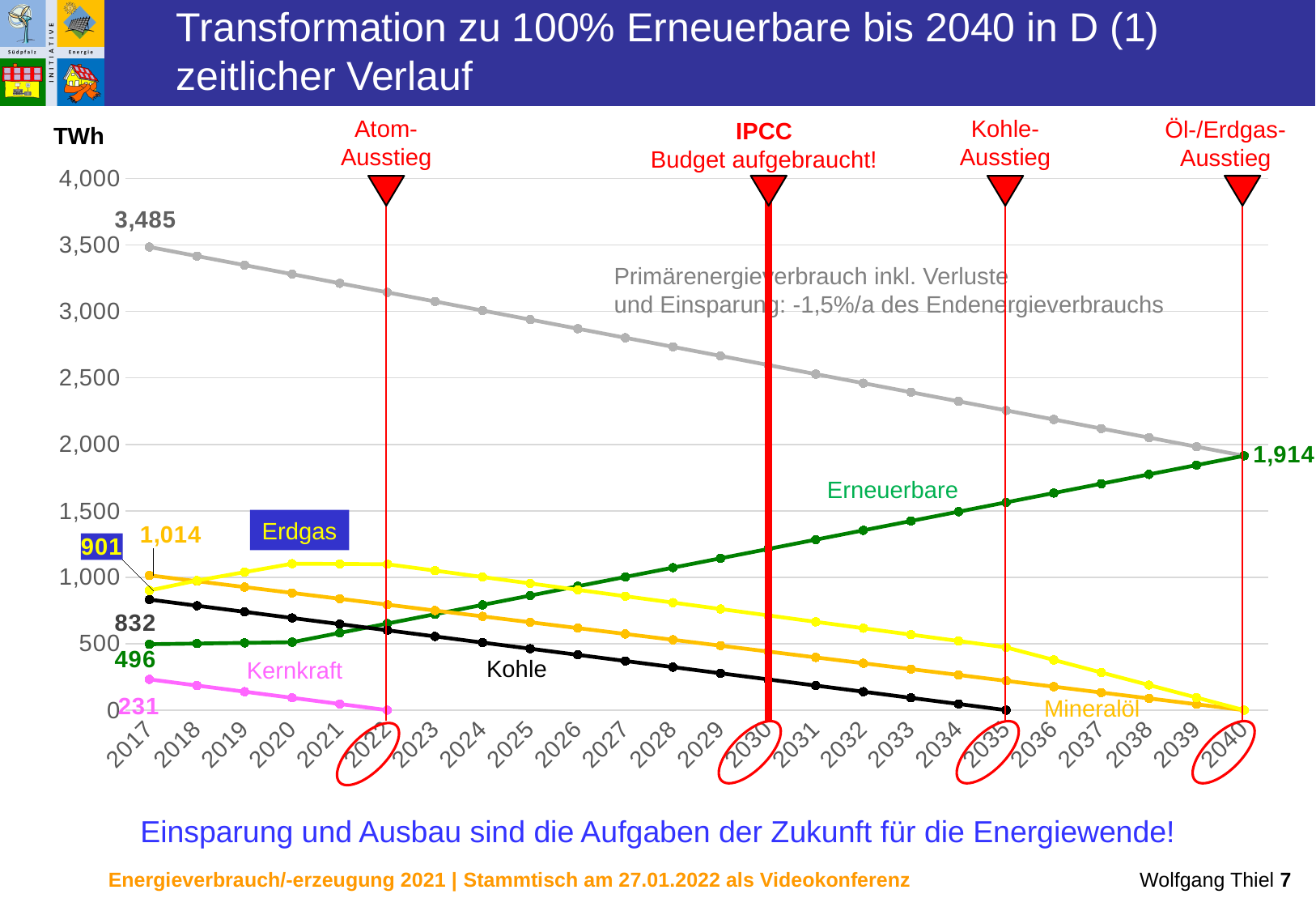
In 2017, which is larger: Mineralöl or Erdgas? Mineralöl What value does the Erneuerbare series reach in 2040? 1,914 Is the value for Kohle in 2030 greater or less than 500? less What is the value of Erneuerbare in 2017? 496 What is the value of Kohle in 2017? 832 Does the Primärenergieverbrauch series rise or fall from 2017 to 2040? fall What is the value of Kernkraft in 2017? 231 What type of chart is shown on the slide? line chart By how much does the Erneuerbare series increase from 2017 to 2040? 1,418 In which year is the Kohle-Ausstieg marked on the chart? 2035 What is the value of Primärenergieverbrauch in 2017? 3,485 What is the value of Mineralöl in 2017? 1,014